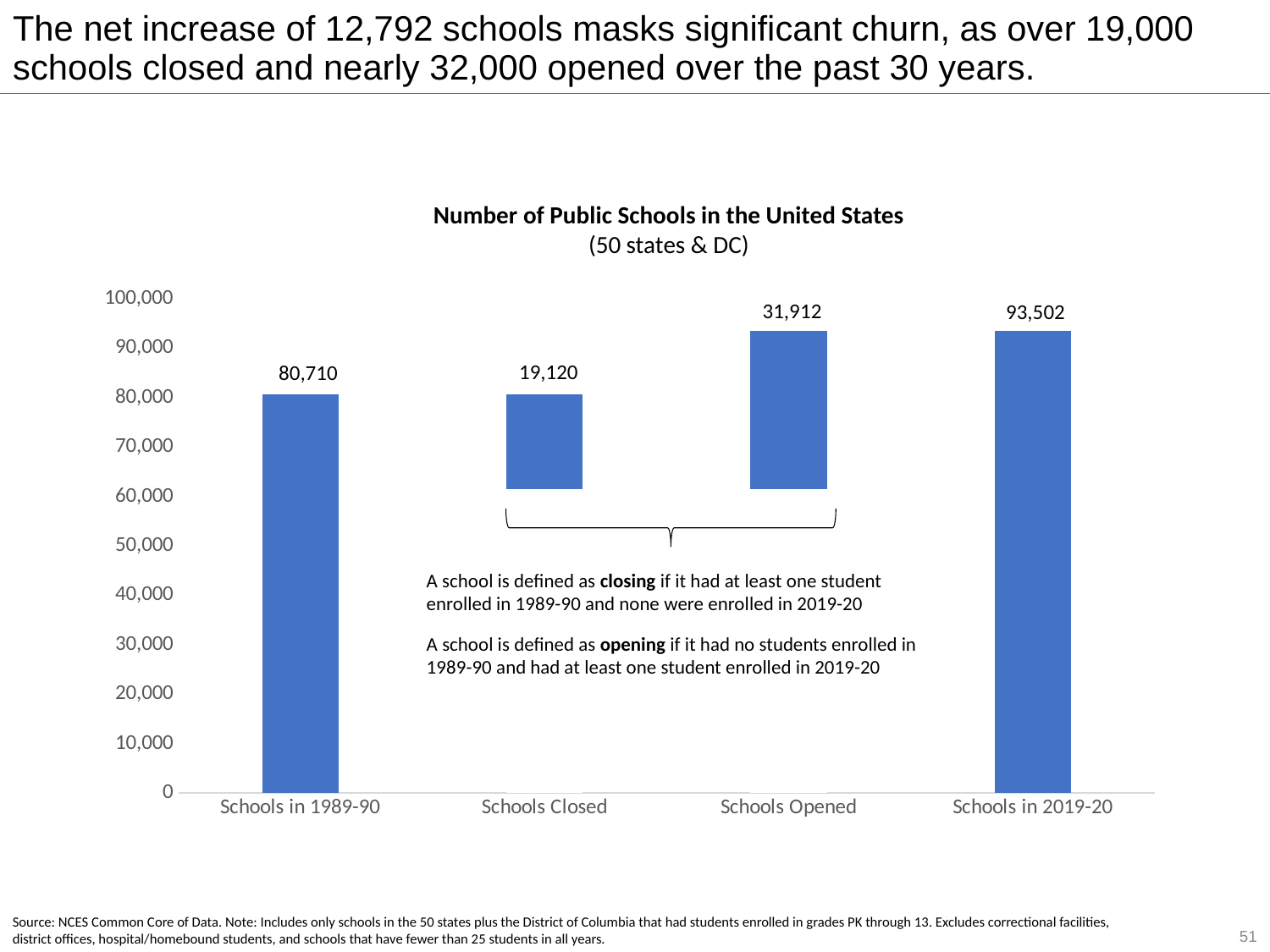
What is the value shown for Schools Opened? 31,912 What is the value shown for Schools in 2019-20? 93,502 Which is larger, Schools Opened or Schools Closed? Schools Opened What is the difference between Schools Opened and Schools Closed? 12,792 What is the difference between Schools in 2019-20 and Schools in 1989-90? 12,792 How many categories are shown on the x axis? 4 What is the value shown for Schools in 1989-90? 80,710 What is the title of the chart? Number of Public Schools in the United States Which category has the lowest value? Schools Closed What kind of chart is shown on the slide? Bar chart What is the value shown for Schools Closed? 19,120 Which category has the highest value? Schools in 2019-20